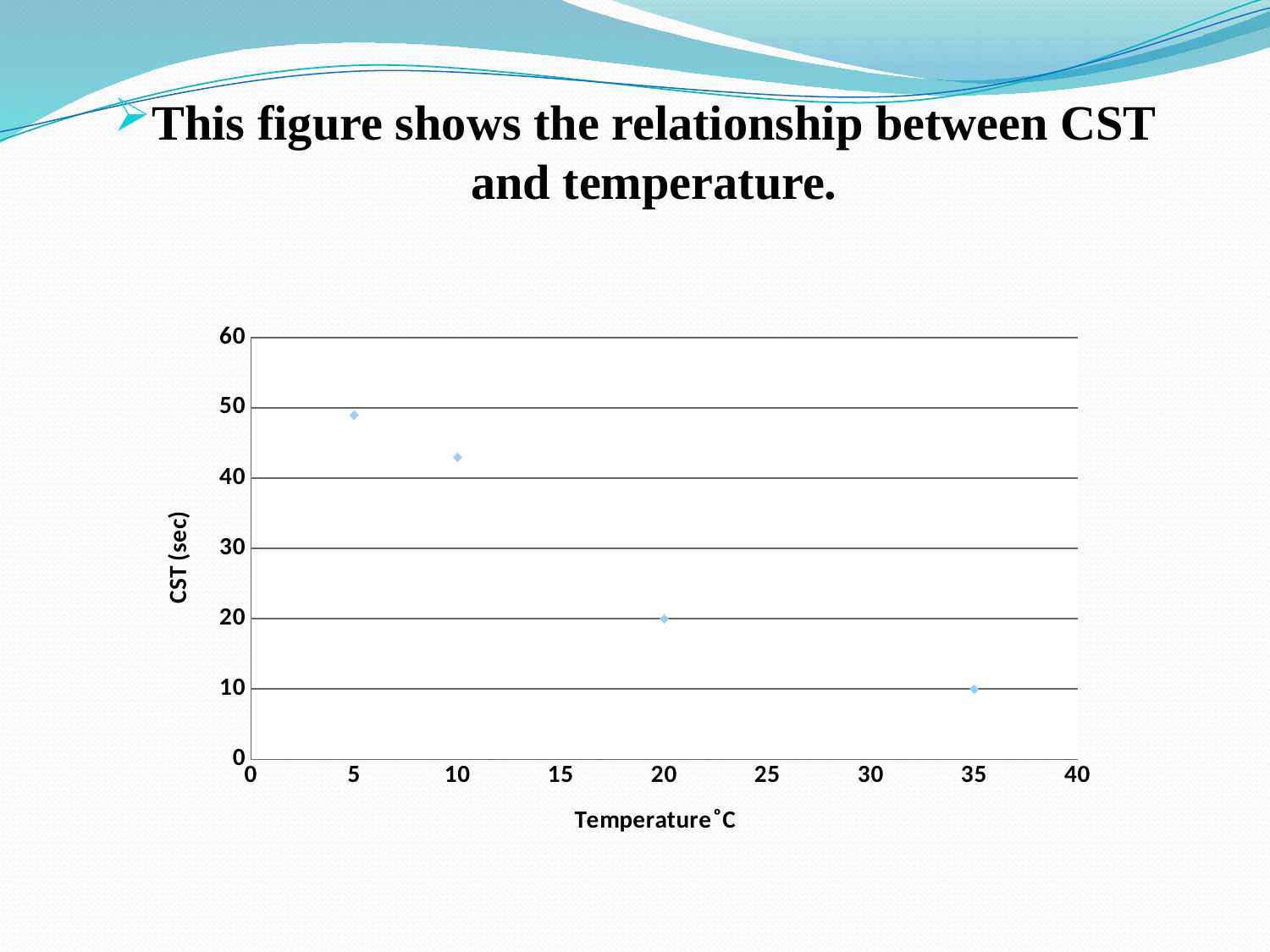
At which temperature is the CST value highest? 5 Do the CST values rise or fall as temperature increases along the x axis? fall What is the difference between the CST values at 20°C and 35°C? 10 What kind of chart is shown on the slide? scatter chart Is the CST value at 10°C greater or less than 50? less What is the CST value at a temperature of 35°C? 10 What is the label of the vertical axis? CST (sec) Is the CST value at 5°C greater or less than 40? greater Which has a larger CST value, the point at 10°C or the point at 20°C? 10°C How many data points are plotted on the chart? 4 At which temperature is the CST value lowest? 35 What is the CST value at a temperature of 20°C? 20